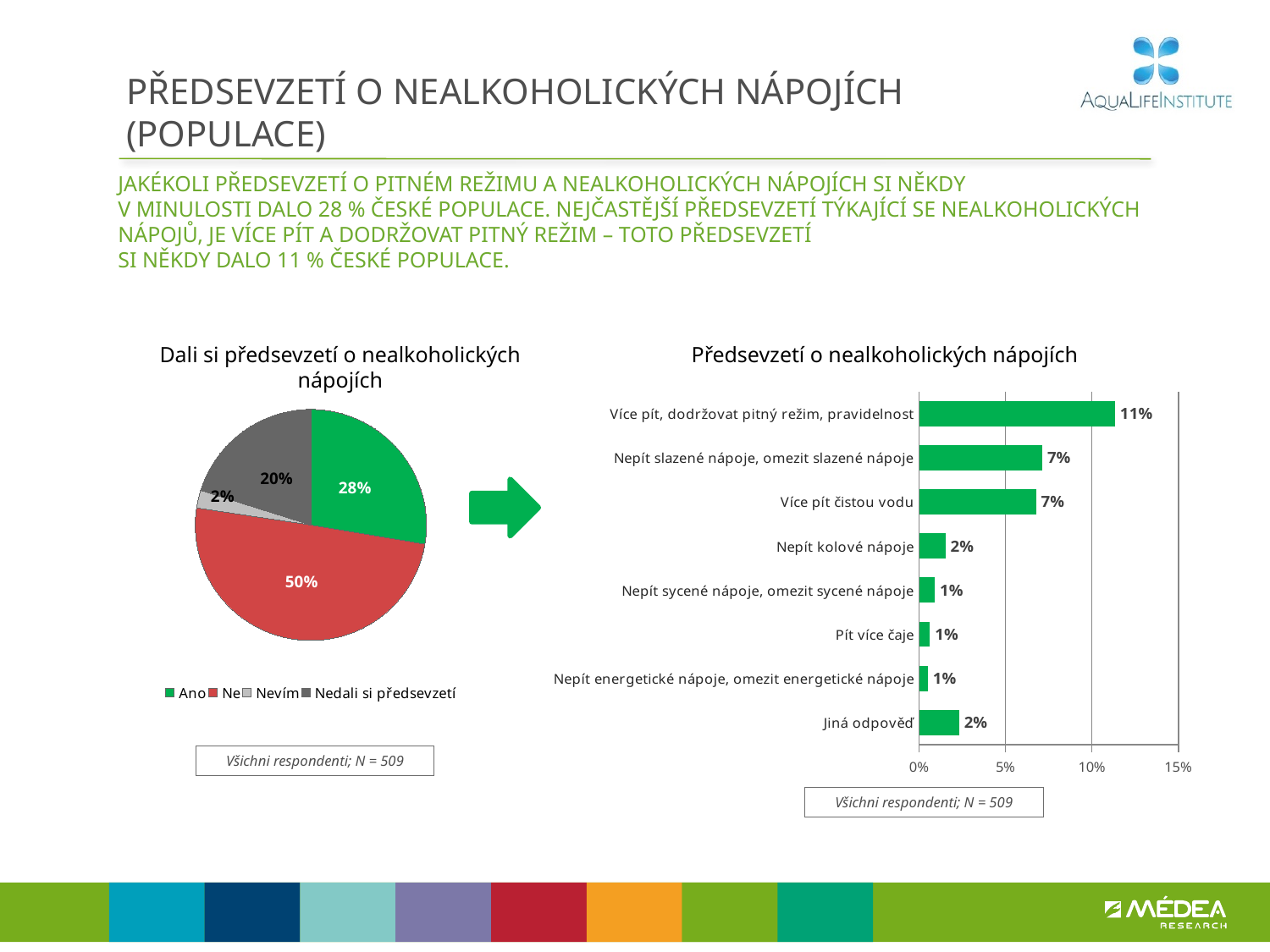
In the pie chart 'Dali si předsevzetí o nealkoholických nápojích', what is the difference between the 'Ne' and 'Ano' shares? 22% In the pie chart 'Dali si předsevzetí o nealkoholických nápojích', how many entries does the legend list? 4 What kind of chart is 'Předsevzetí o nealkoholických nápojích' on the right side of the slide? bar chart In the bar chart 'Předsevzetí o nealkoholických nápojích', which category has the highest value? Více pít, dodržovat pitný režim, pravidelnost In the pie chart 'Dali si předsevzetí o nealkoholických nápojích', which category has the largest slice? Ne In the pie chart 'Dali si předsevzetí o nealkoholických nápojích', what share of respondents answered 'Ne'? 50% In the bar chart 'Předsevzetí o nealkoholických nápojích', is the value for 'Více pít, dodržovat pitný režim, pravidelnost' greater or less than 10%? greater In the pie chart 'Dali si předsevzetí o nealkoholických nápojích', which category has the smallest slice? Nevím In the pie chart 'Dali si předsevzetí o nealkoholických nápojích', what share of respondents answered 'Ano'? 28% In the bar chart 'Předsevzetí o nealkoholických nápojích', what is the value for 'Více pít, dodržovat pitný režim, pravidelnost'? 11% In the bar chart 'Předsevzetí o nealkoholických nápojích', what is the value for 'Nepít kolové nápoje'? 2% In the bar chart 'Předsevzetí o nealkoholických nápojích', how many categories are shown? 8